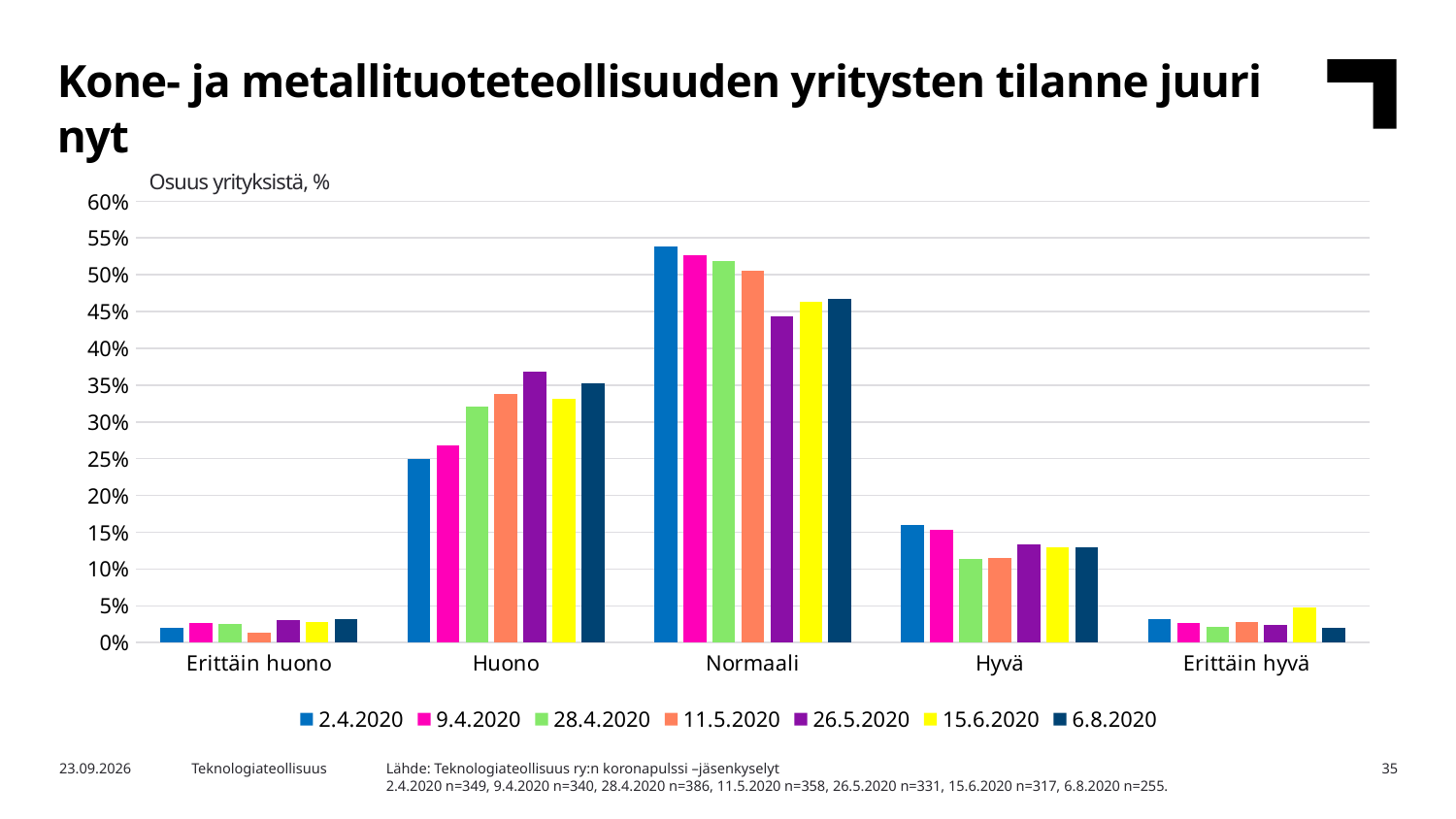
Is the value for Normaali on 2.4.2020 greater or less than 50%? greater For Normaali, which is larger: the value for 2.4.2020 or the value for 26.5.2020? 2.4.2020 Within the Erittäin hyvä category, which survey date has the highest value? 15.6.2020 Which category has the highest value for the 2.4.2020 series? Normaali How many series does the legend list? 7 Is the value for Erittäin huono on 11.5.2020 greater or less than 5%? less Is the value for Hyvä on 2.4.2020 greater or less than 10%? greater How many categories are shown on the x axis? 5 Within the Normaali category, which survey date has the lowest value? 26.5.2020 Within the Huono category, which survey date has the highest value? 26.5.2020 What kind of chart is shown on the slide? bar chart